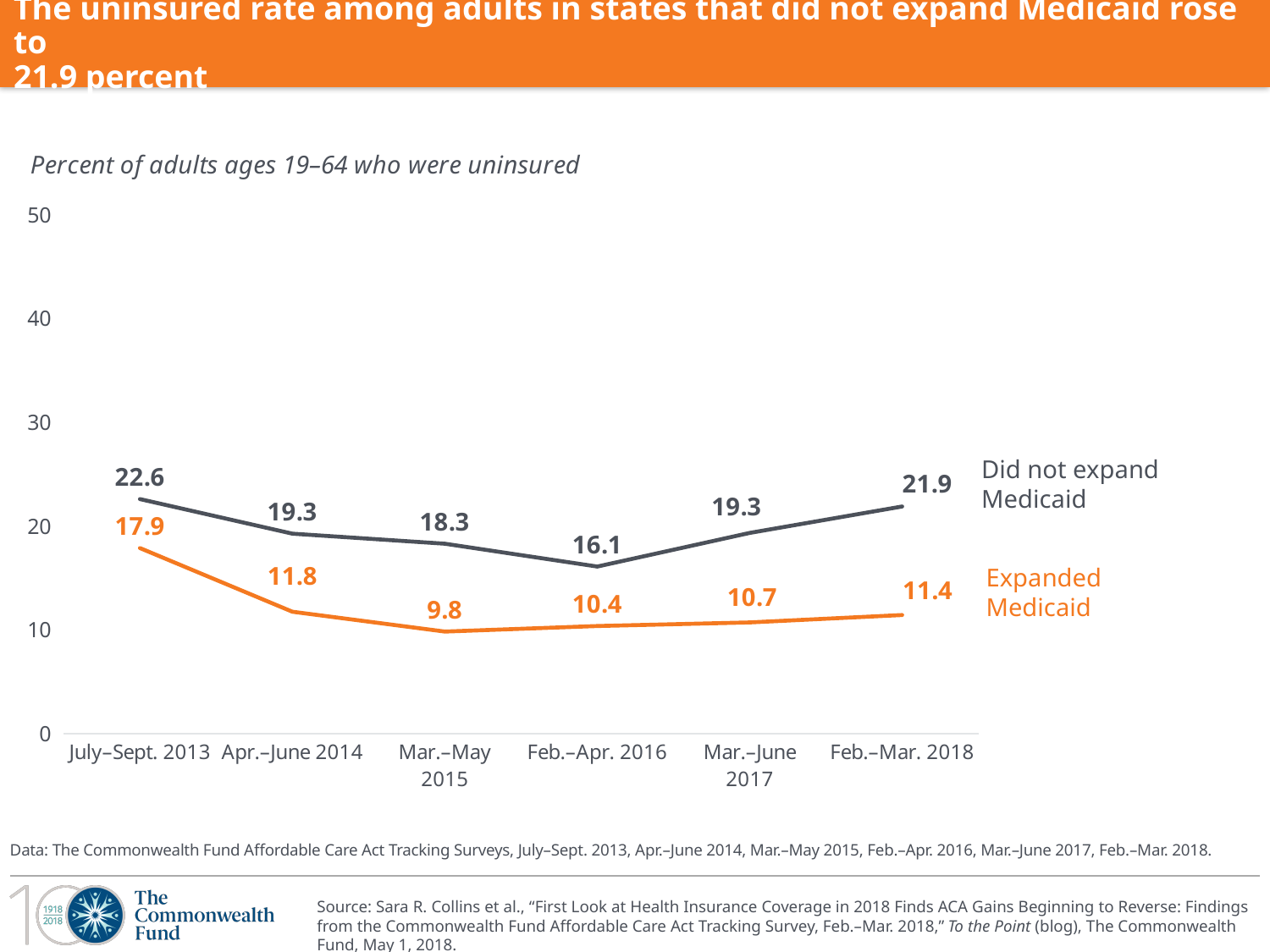
How many series are plotted on the chart? 2 What is the difference between the Did not expand Medicaid and Expanded Medicaid rates in Feb.–Mar. 2018? 10.5 Which group had the higher uninsured rate in Apr.–June 2014, Did not expand Medicaid or Expanded Medicaid? Did not expand Medicaid What was the uninsured rate for states that expanded Medicaid in Mar.–May 2015? 9.8 By how much did the uninsured rate for states that did not expand Medicaid change from Feb.–Apr. 2016 to Feb.–Mar. 2018? 5.8 How many survey periods are shown on the x axis? 6 Did the uninsured rate for states that expanded Medicaid rise or fall from July–Sept. 2013 to Mar.–May 2015? Fall What type of chart is shown on the slide? Line chart In which survey period was the uninsured rate for states that did not expand Medicaid lowest? Feb.–Apr. 2016 What was the uninsured rate for states that expanded Medicaid in July–Sept. 2013? 17.9 In which survey period was the uninsured rate for states that expanded Medicaid highest? July–Sept. 2013 What was the uninsured rate for states that did not expand Medicaid in Feb.–Mar. 2018? 21.9